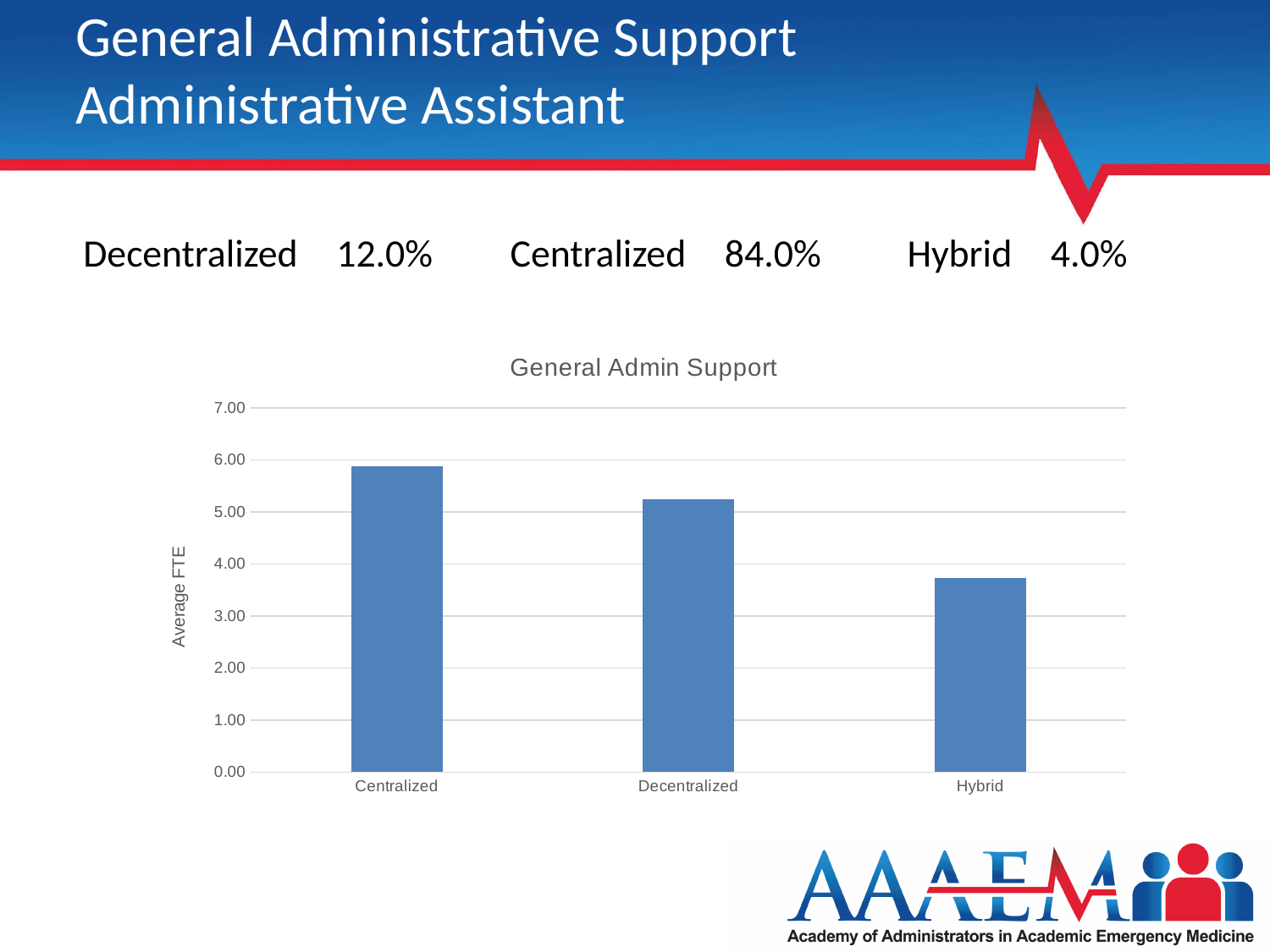
Which category has the lowest average FTE? Hybrid Which has a higher average FTE, Centralized or Decentralized? Centralized Is the value for Centralized greater or less than 5.00? greater Which has a higher average FTE, Decentralized or Hybrid? Decentralized What is the title of the chart? General Admin Support How many categories are plotted in the chart? 3 What is the label on the vertical axis of the chart? Average FTE What kind of chart is shown on the slide? bar chart Which category has the highest average FTE? Centralized Is the value for Decentralized greater or less than 6.00? less Is the value for Hybrid greater or less than 4.00? less Do the bar values rise or fall from left to right across the categories? fall